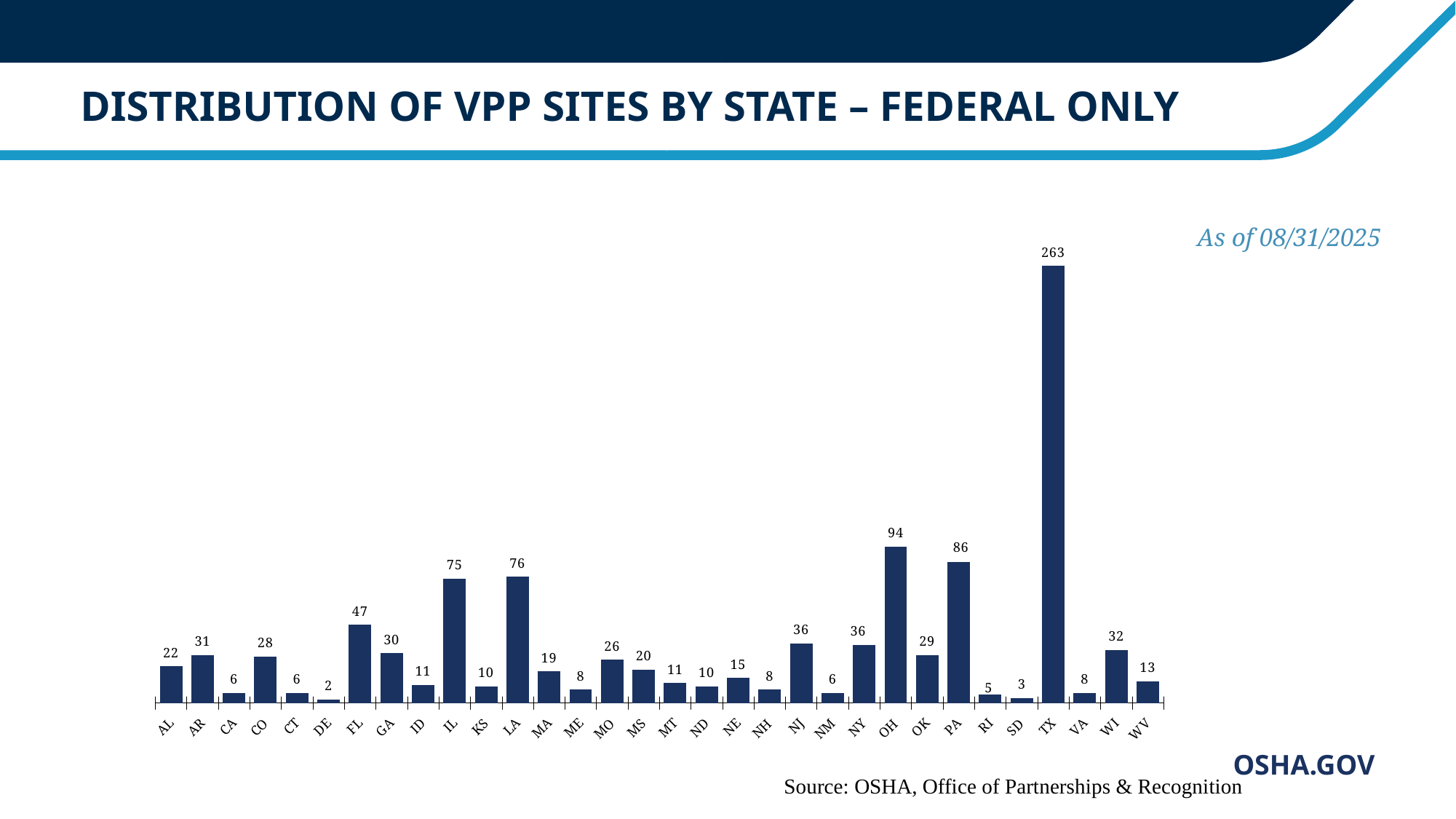
Which is larger, the value for FL or the value for GA? FL What is the title of the chart? Distribution of VPP Sites by State – Federal Only What kind of chart is shown on the slide? Bar chart How many states are shown on the x axis? 32 What is the difference between the values for OH and PA? 8 What is the value for TX? 263 Which state has the highest number of VPP sites? TX What is the 'as of' date shown on the slide? 08/31/2025 What is the value for DE? 2 What is the value for OH? 94 Which state has the lowest number of VPP sites? DE What is the value for FL? 47